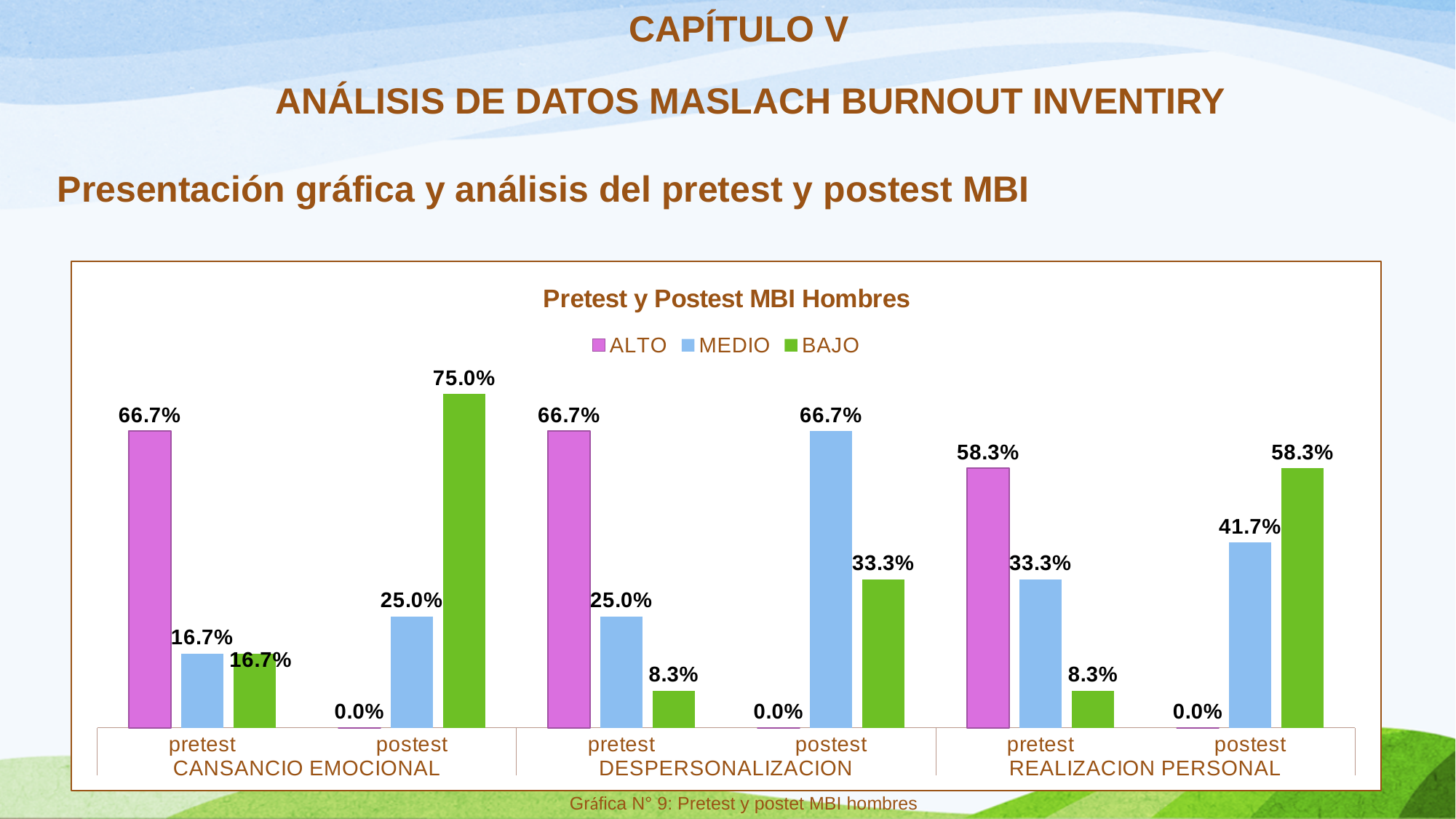
How many series does the legend list? 3 What is the ALTO value for the REALIZACION PERSONAL pretest? 58.3% What is the title of the chart? Pretest y Postest MBI Hombres Which is larger: the MEDIO value for the REALIZACION PERSONAL postest or the MEDIO value for the REALIZACION PERSONAL pretest? REALIZACION PERSONAL postest What is the BAJO value for the DESPERSONALIZACION pretest? 8.3% What is the MEDIO value for the DESPERSONALIZACION postest? 66.7% What is the difference between the BAJO value for the CANSANCIO EMOCIONAL postest and the BAJO value for the CANSANCIO EMOCIONAL pretest? 58.3% Which series has the lowest value in the REALIZACION PERSONAL postest group? ALTO Which series has the highest value in the CANSANCIO EMOCIONAL pretest group? ALTO How many pretest/postest groups are shown along the x axis? 6 What is the BAJO value for the CANSANCIO EMOCIONAL postest? 75.0% What kind of chart is shown on the slide? bar chart